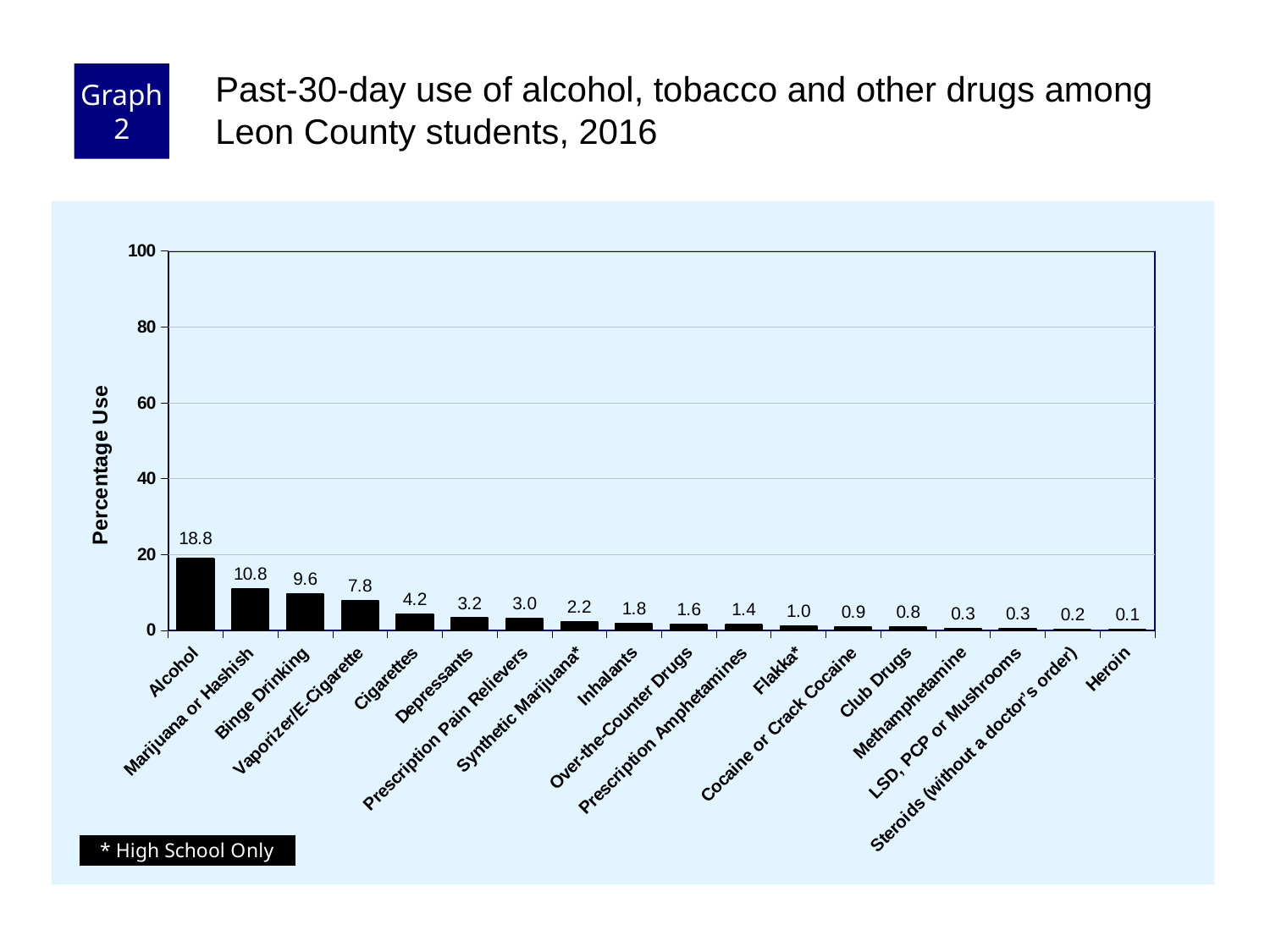
Which category has the lowest percentage use? Heroin What is the difference between the values for Binge Drinking and Cigarettes? 5.4 Which category has the highest percentage use? Alcohol What is the label of the y axis? Percentage Use What kind of chart is shown on the slide? bar chart Which is larger, the value for Depressants or the value for Prescription Pain Relievers? Depressants What is the difference between the values for Alcohol and Marijuana or Hashish? 8.0 How many categories are shown on the x axis? 18 What is the past-30-day use percentage for Alcohol? 18.8 Is the value for Alcohol greater or less than 20? less What is the value shown for Vaporizer/E-Cigarette? 7.8 What is the value shown for Inhalants? 1.8